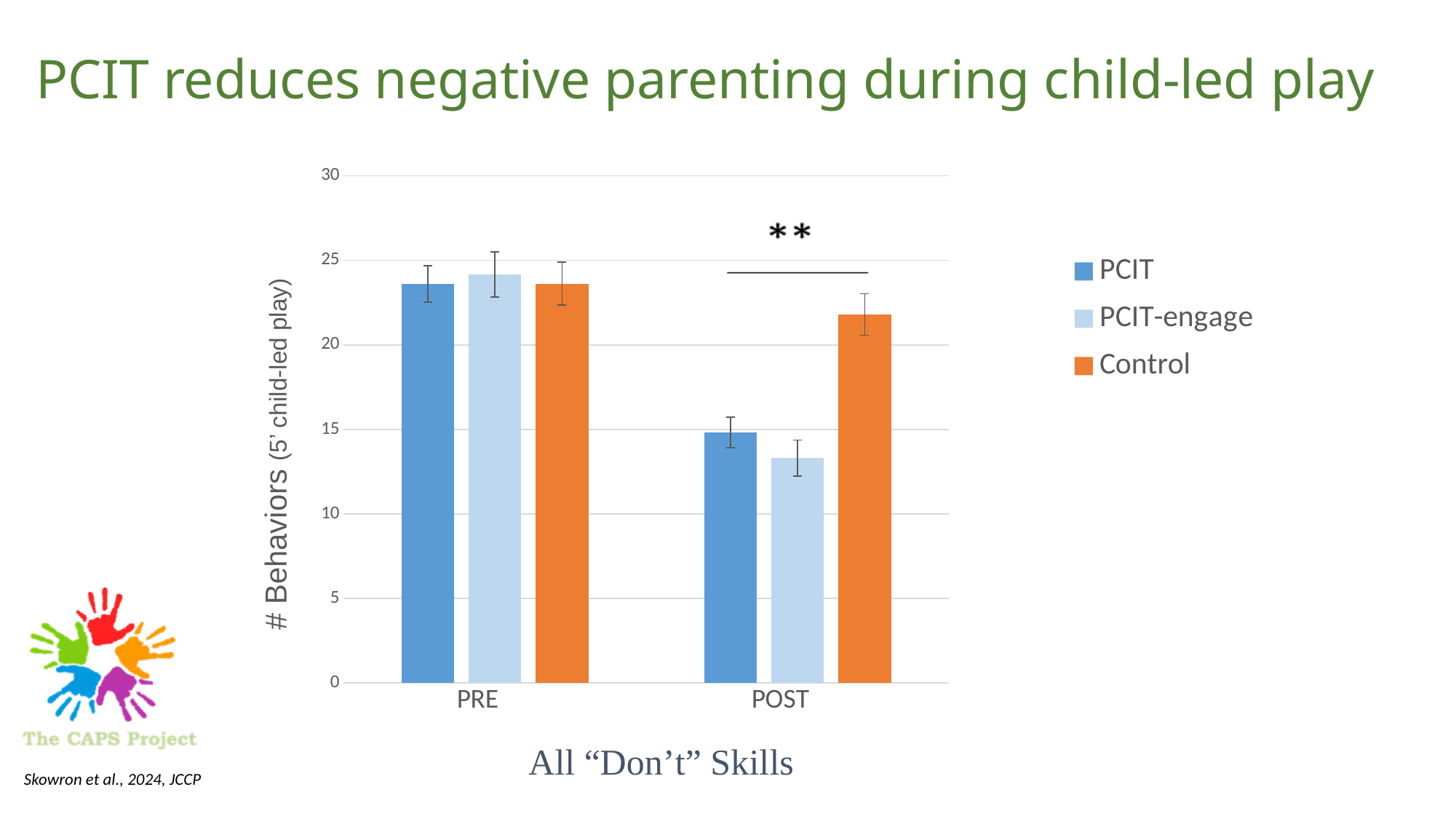
How many categories are shown on the x axis? 2 Is the value for PCIT at POST greater or less than 10? greater Is the value for Control at POST greater or less than 20? greater What is the label on the y axis of the chart? # Behaviors (5' child-led play) Which series has the lowest value at POST? PCIT-engage Which series has the highest value at POST? Control Is the value for PCIT at PRE greater or less than 20? greater How many series does the legend list? 3 What kind of chart is shown on the slide? bar chart Does the value for PCIT rise or fall from PRE to POST? fall At POST, which is larger: the value for Control or the value for PCIT-engage? Control